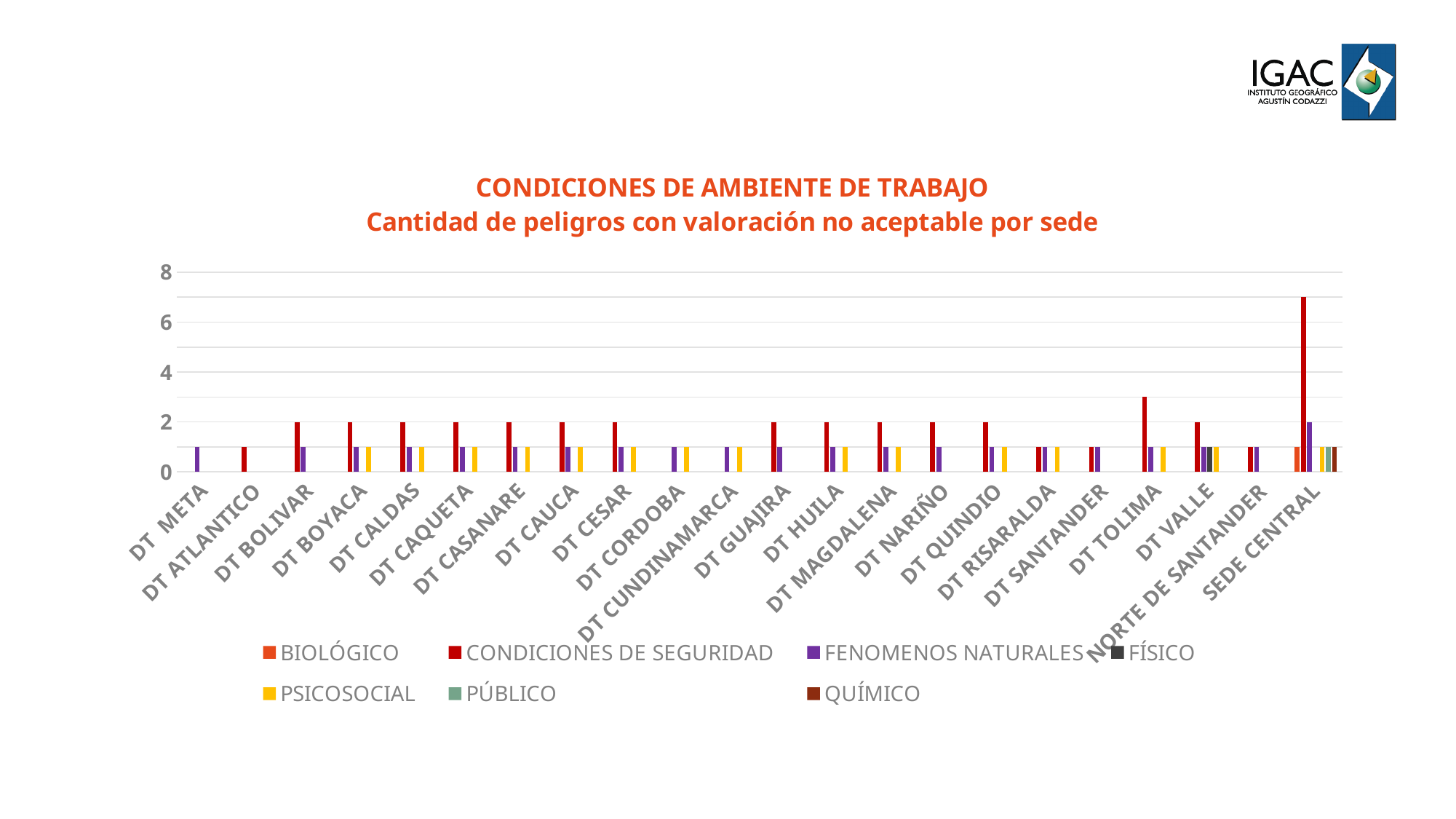
What is the title of the chart? CONDICIONES DE AMBIENTE DE TRABAJO Cantidad de peligros con valoración no aceptable por sede How many sedes (categories) are shown along the x axis? 22 What is the CONDICIONES DE SEGURIDAD value for DT BOLIVAR? 2 Is the CONDICIONES DE SEGURIDAD value for DT TOLIMA greater or less than 4? less Which sede has the highest bar in the chart? SEDE CENTRAL What kind of chart is shown on the slide? Bar chart How many series does the legend list? 7 Which series has the tallest bar for SEDE CENTRAL? CONDICIONES DE SEGURIDAD Which has the larger CONDICIONES DE SEGURIDAD value, DT TOLIMA or DT VALLE? DT TOLIMA Which series is shown in yellow in the legend? PSICOSOCIAL Is the CONDICIONES DE SEGURIDAD value for DT TOLIMA greater or less than 2? greater Is the CONDICIONES DE SEGURIDAD value for SEDE CENTRAL greater or less than 6? greater